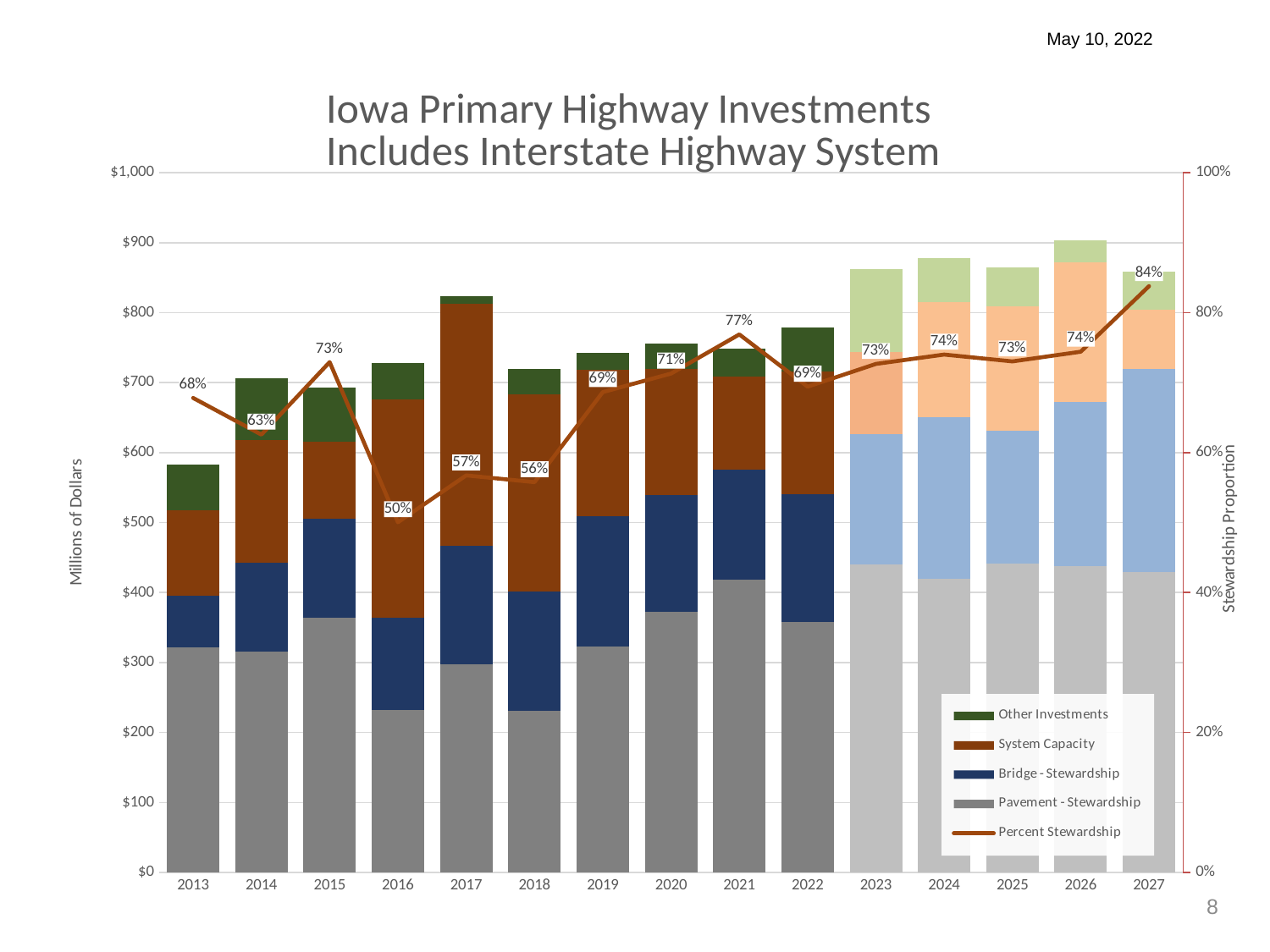
How many series does the legend list? 5 How many years are shown on the x axis? 15 By how many percentage points does Percent Stewardship in 2027 exceed that in 2016? 34 percentage points Which year has the highest Percent Stewardship? 2027 Which year has the higher Percent Stewardship, 2020 or 2021? 2021 Is the total investment bar for 2017 greater or less than $800 million? greater Does Percent Stewardship rise or fall from 2018 to 2021? rise Is the total investment bar for 2013 greater or less than $600 million? less What is the Percent Stewardship value for 2016? 50% What is the Percent Stewardship value for 2021? 77% Which year has the lowest Percent Stewardship? 2016 What is the Percent Stewardship value for 2027? 84%